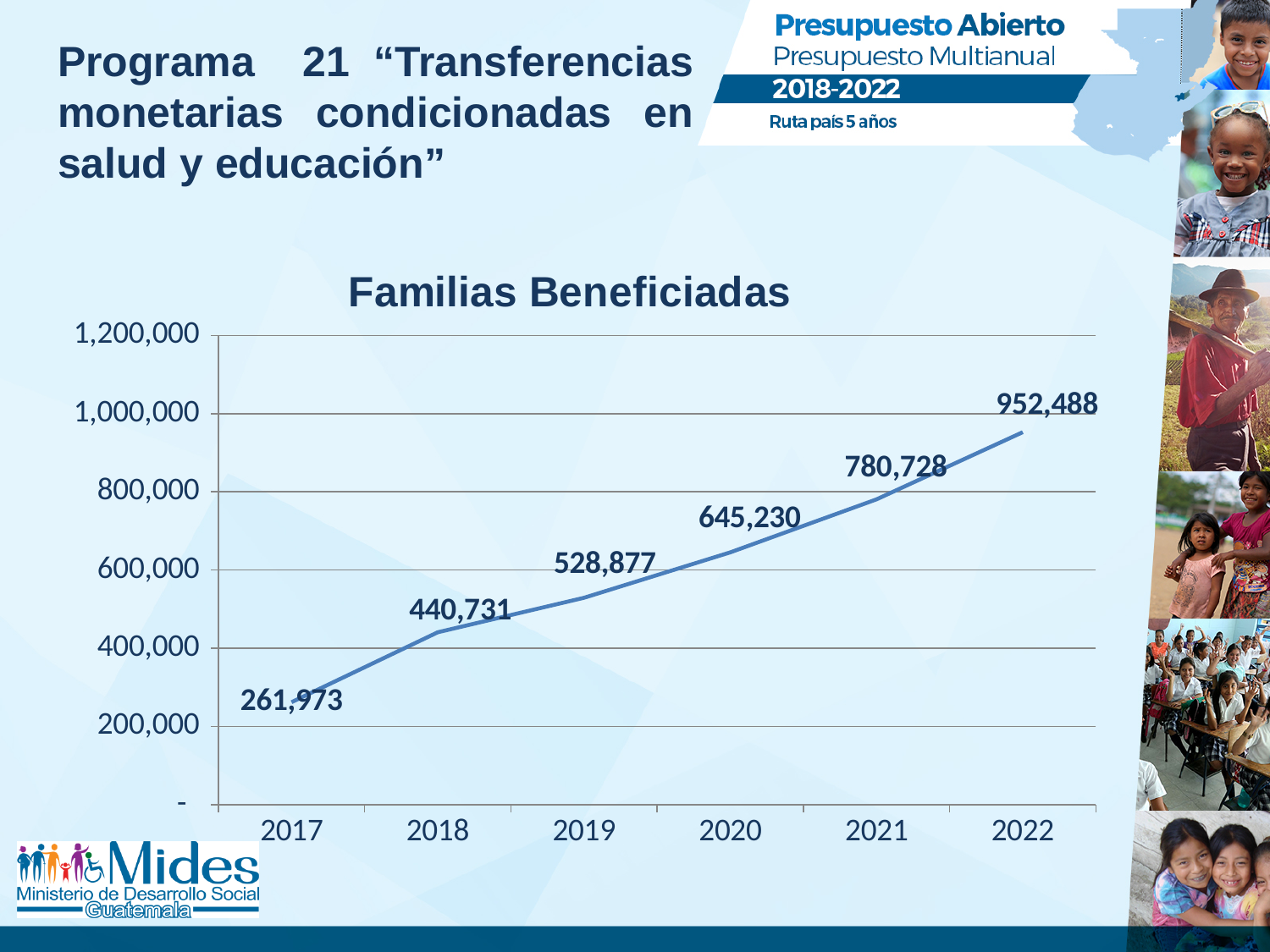
What is the difference between the values for 2022 and 2017? 690,515 What is the value for 2019? 528,877 What is the difference between the values for 2018 and 2017? 178,758 Do the values rise or fall from 2017 to 2022? rise What is the value for 2017? 261,973 Which year has the lowest value? 2017 What is the title of the chart? Familias Beneficiadas What is the value for 2021? 780,728 How many years are plotted on the x axis? 6 Which year has the highest value? 2022 What kind of chart is shown on the slide? line chart Which is larger, the value for 2020 or the value for 2019? 2020